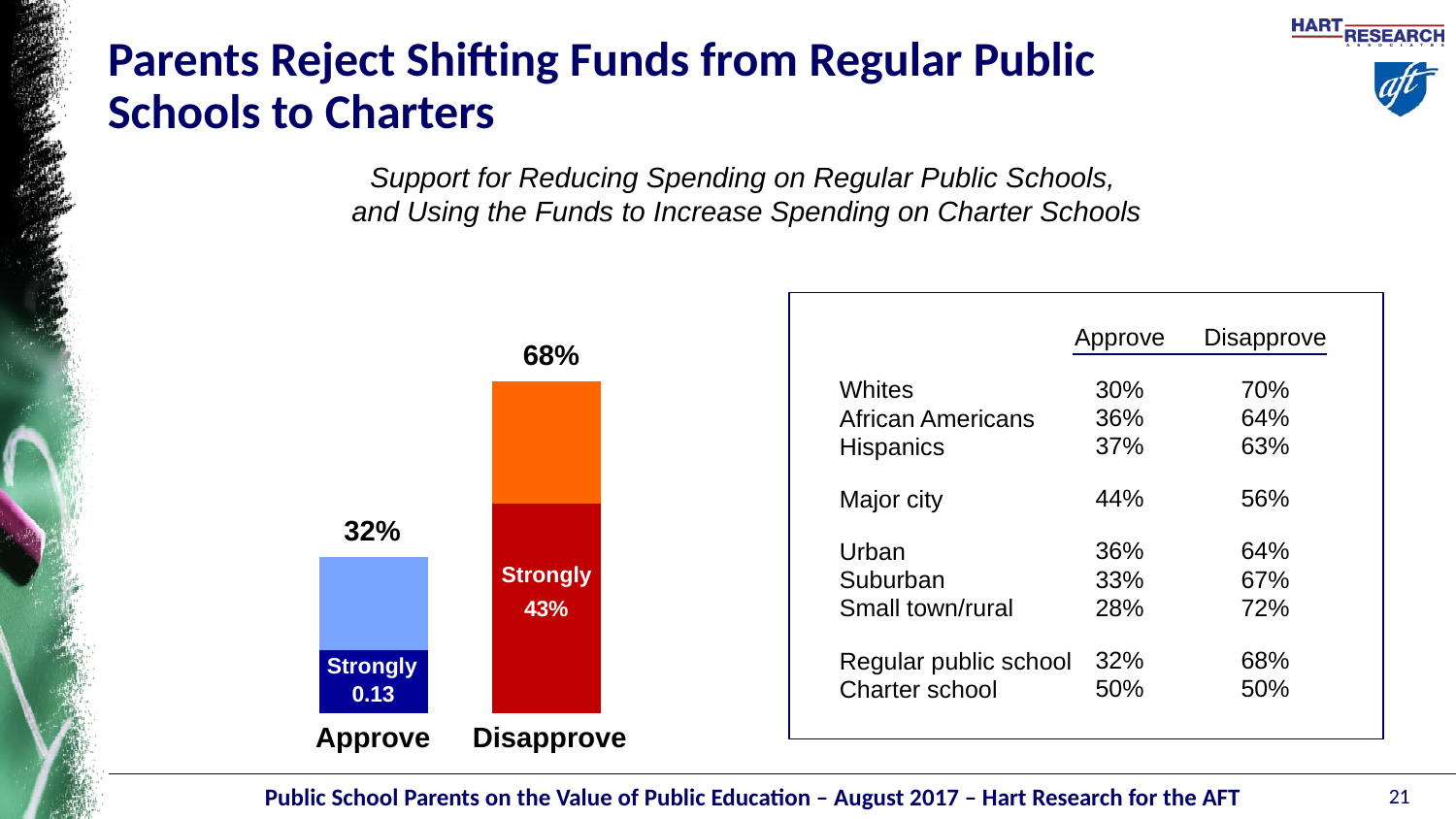
Is the Approve total larger or smaller than the Disapprove total? Smaller Which category has the lower total value in the bar chart? Approve What kind of chart is shown on the left of the slide? Stacked bar chart Which bar has the larger 'Strongly' segment, Approve or Disapprove? Disapprove Which category has the higher total value in the bar chart? Disapprove What is the total value shown for the Approve bar? 32% What value is labeled for the 'Strongly' segment of the Approve bar? 0.13 What is the subtitle describing what the chart measures? Support for Reducing Spending on Regular Public Schools, and Using the Funds to Increase Spending on Charter Schools What is the difference between the Disapprove total and the Approve total? 36 percentage points What value is labeled for the 'Strongly' segment of the Disapprove bar? 43% What is the total value shown for the Disapprove bar? 68% How many categories are shown on the x axis of the bar chart? 2